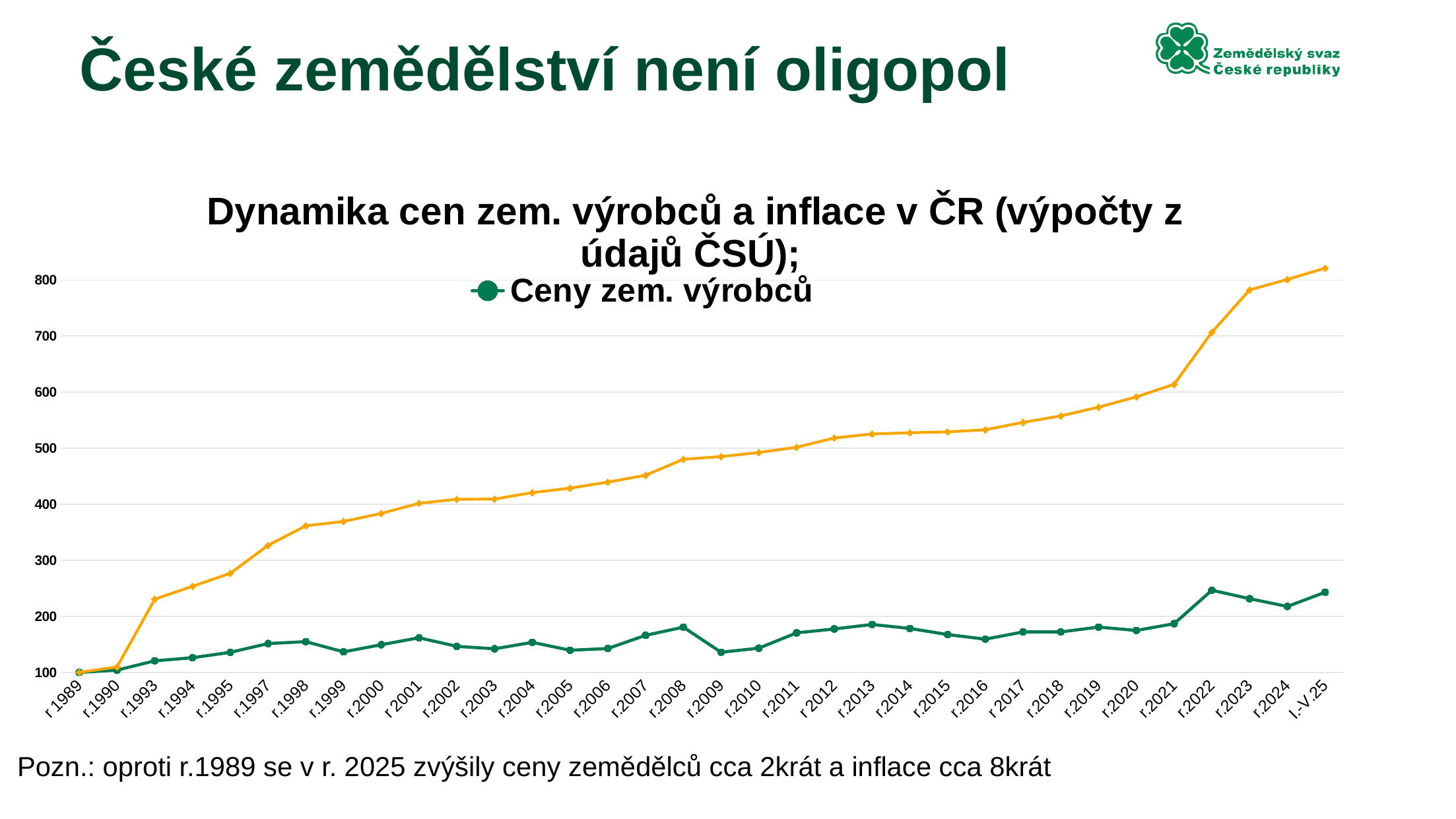
What kind of chart is shown on the slide? line chart Is the value of the orange line for r.2023 greater or less than 700? greater Is the value of Ceny zem. výrobců for r.2009 greater or less than 200? less Does the orange line generally rise or fall from r.1989 to I.-V.25? rise What is the value of Ceny zem. výrobců in r.1989? 100 In r.2024, which line has the higher value, the orange line or Ceny zem. výrobců? the orange line Is the value of Ceny zem. výrobců for r.2022 greater or less than 200? greater How many time points are shown along the x axis? 34 At which time point does the orange line reach its highest value? I.-V.25 How many series does the chart legend list? 1